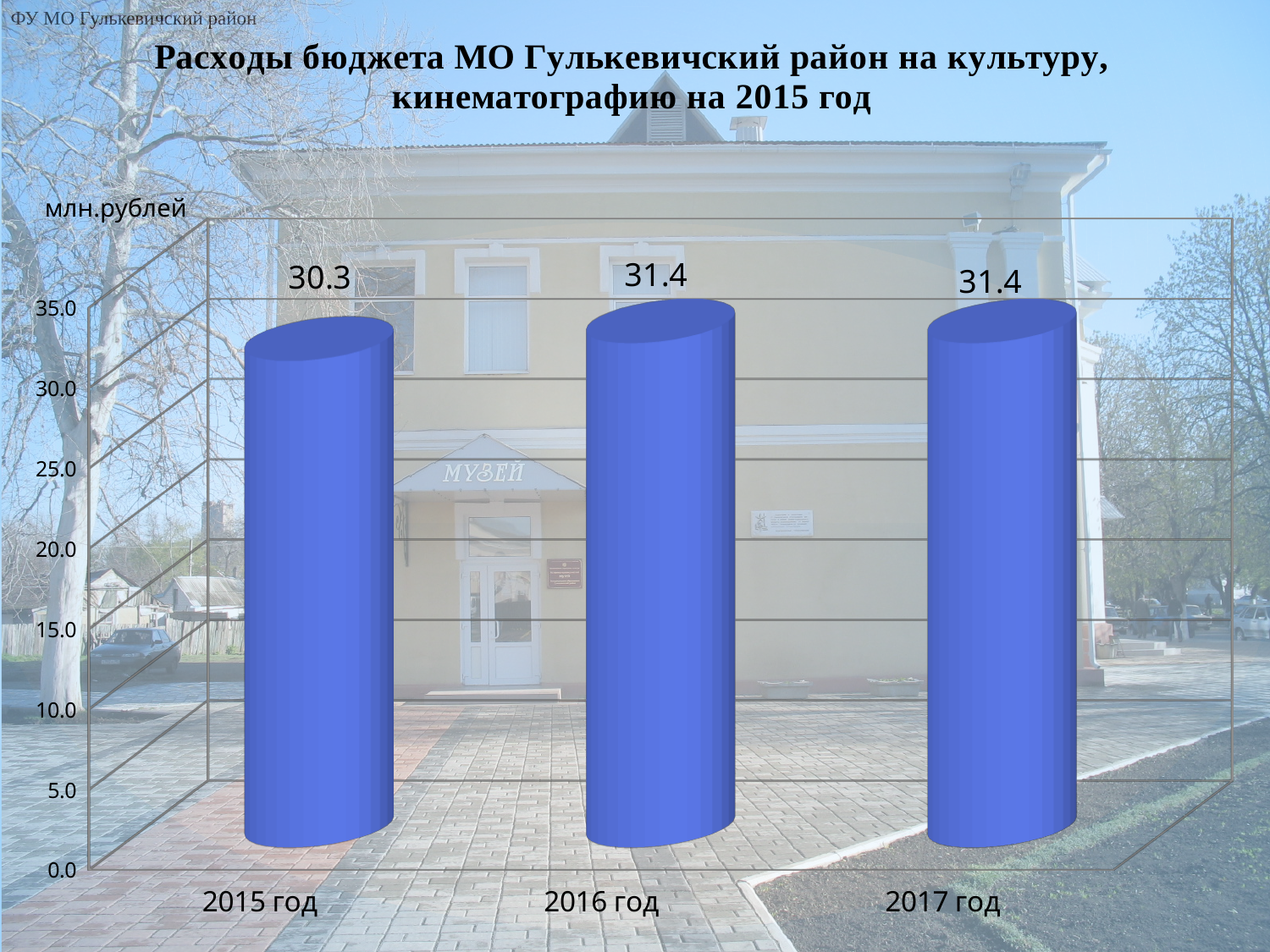
Is the value for 2015 год greater or less than 35.0? less Is the value for 2017 год greater or less than 25.0? greater Do the values rise or fall from 2015 год to 2016 год? rise Which year has the lowest value? 2015 год What kind of chart is shown on the slide? bar chart How many years are shown on the chart? 3 What is the value for 2016 год? 31.4 What unit is shown on the chart's vertical axis label? млн.рублей Which is larger, the value for 2015 год or the value for 2016 год? 2016 год What is the difference between the values for 2016 год and 2015 год? 1.1 What is the value for 2015 год? 30.3 What is the value for 2017 год? 31.4